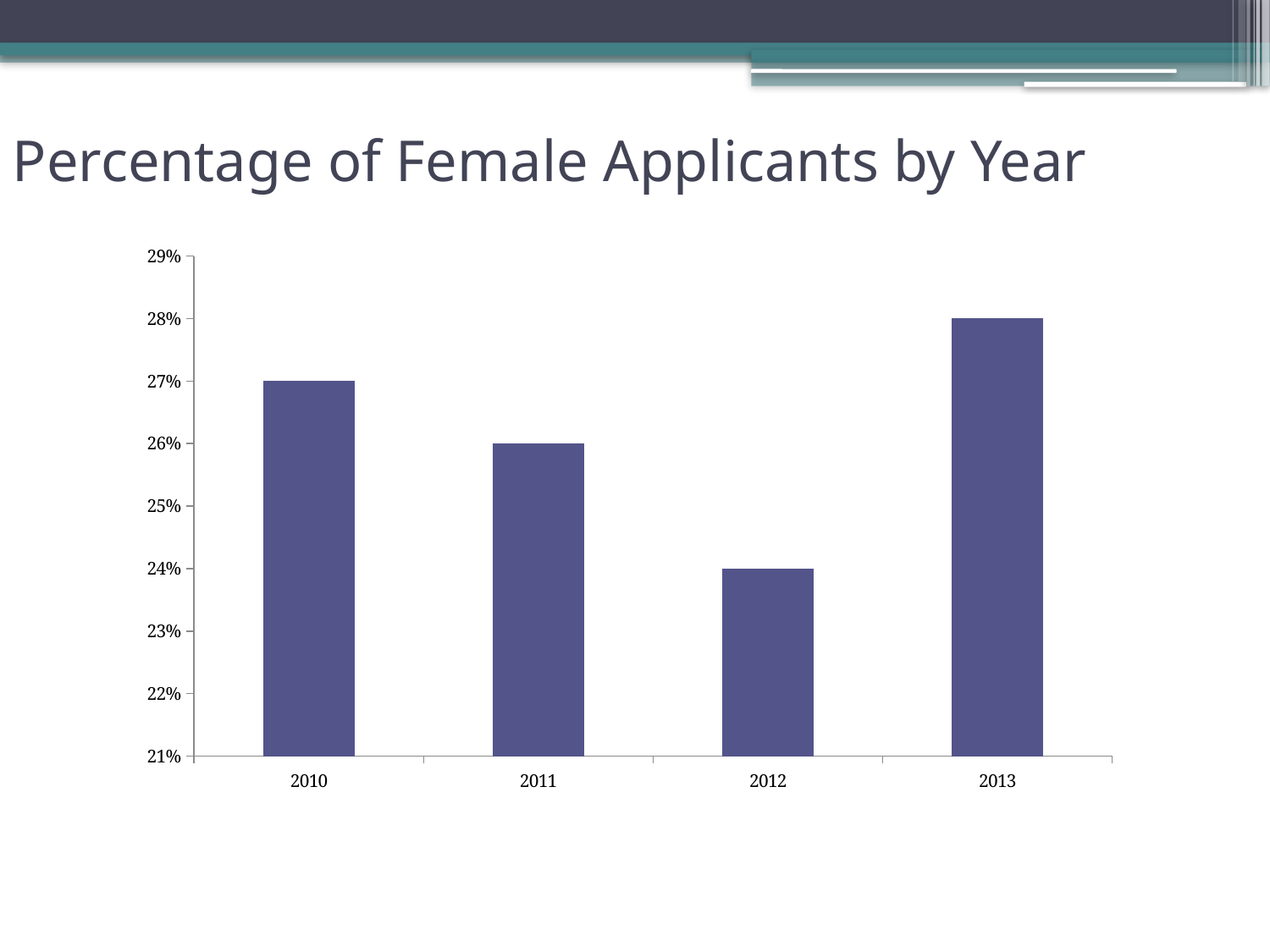
How many years are shown on the chart? 4 Which year has the highest percentage of female applicants? 2013 What is the percentage of female applicants in 2010? 27% What is the percentage of female applicants in 2012? 24% What is the title of the slide? Percentage of Female Applicants by Year What is the percentage of female applicants in 2013? 28% Which year has the lowest percentage of female applicants? 2012 Which year has a higher percentage of female applicants, 2010 or 2011? 2010 What is the difference in percentage points between 2013 and 2012? 4 Is the value for 2012 greater or less than 25%? less What is the percentage of female applicants in 2011? 26% What kind of chart is shown on the slide? bar chart